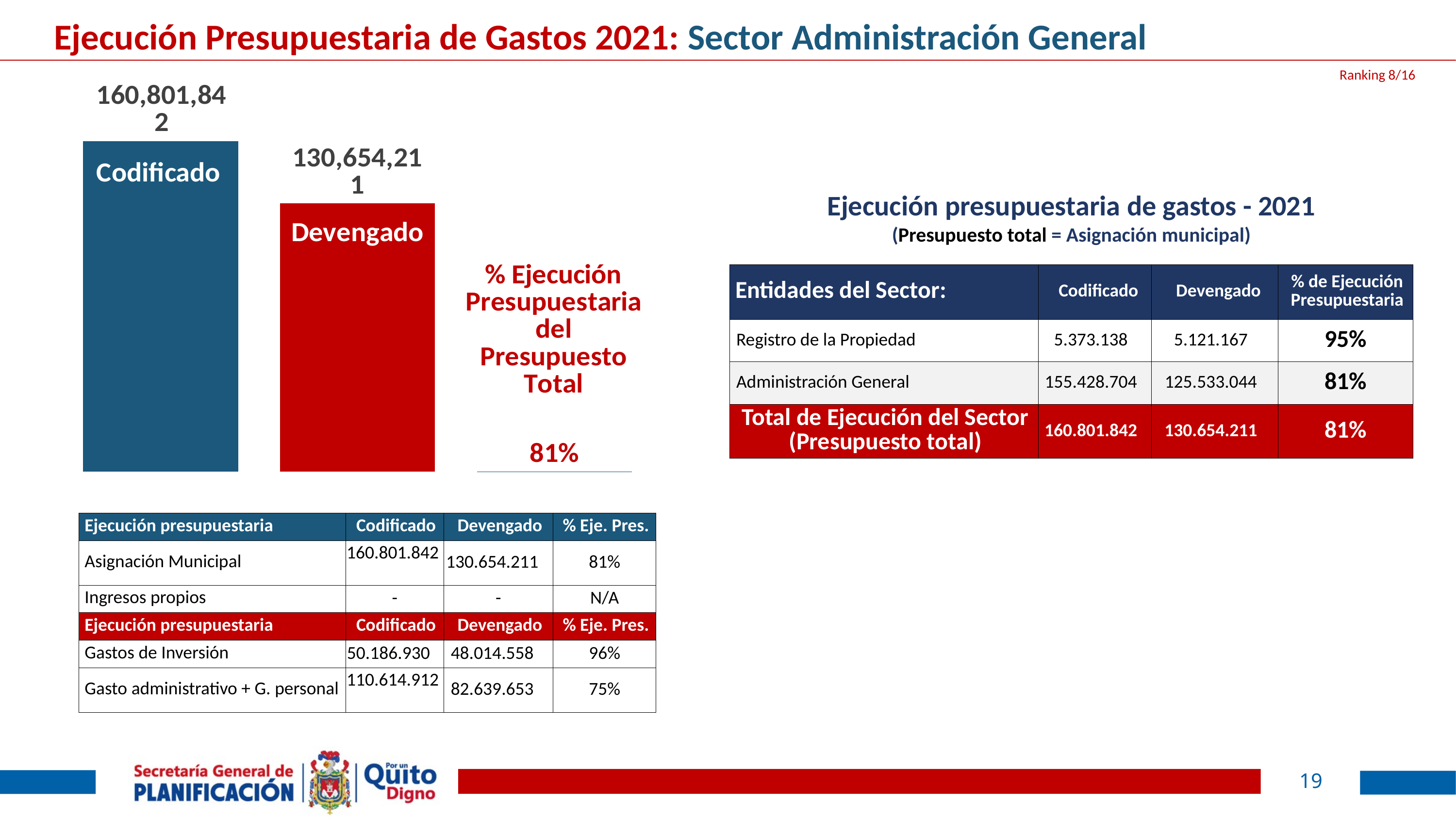
Which is larger in the bar chart, Codificado or Devengado? Codificado Which bar in the chart is the highest? Codificado What colour is the Devengado bar in the chart? Red What is the value of the Devengado bar in the bar chart? 130,654,211 Which bar in the chart is the lowest? Devengado What colour is the Codificado bar in the chart? Blue How many bars are plotted in the chart? 2 What is the difference between the Codificado and Devengado values in the bar chart? 30,147,631 What percentage is shown next to the bar chart as the % Ejecución Presupuestaria del Presupuesto Total? 81% What is the value of the Codificado bar in the bar chart? 160,801,842 What kind of chart is shown on the left of the slide? Bar chart